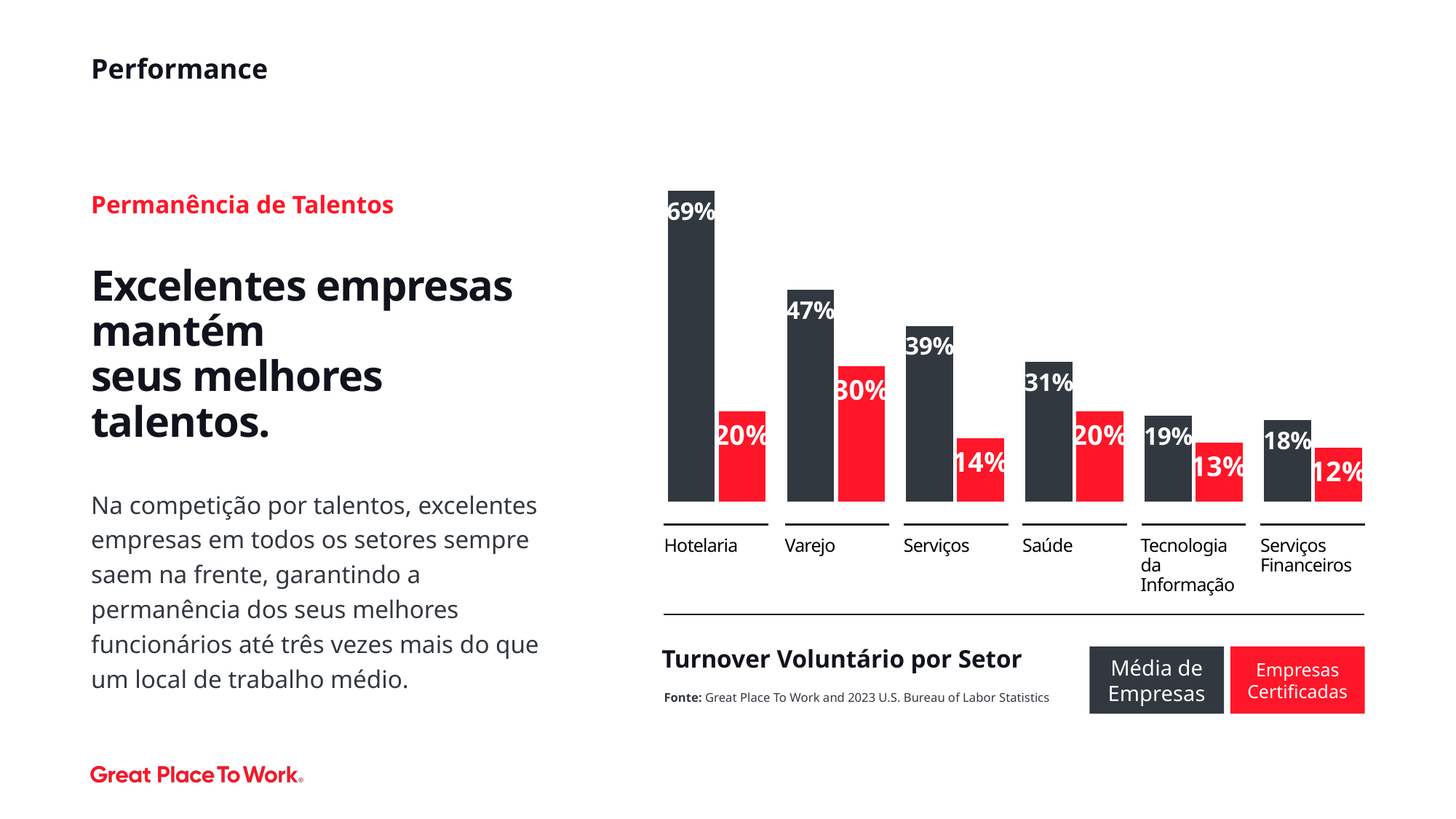
Which is larger: the Empresas Certificadas value for Varejo or for Saúde? Varejo What is the difference between the Média de Empresas and Empresas Certificadas values for Hotelaria? 49 percentage points What is the title of the chart? Turnover Voluntário por Setor What is the Média de Empresas value for Hotelaria? 69% Which sector has the lowest Empresas Certificadas turnover? Serviços Financeiros What is the Empresas Certificadas value for Serviços Financeiros? 12% Which sector has the highest Média de Empresas turnover? Hotelaria Do the Média de Empresas values rise or fall from Hotelaria to Serviços Financeiros? Fall How many series does the legend list? 2 What is the Empresas Certificadas value for Varejo? 30% What kind of chart is shown on the slide? Bar chart How many sectors are shown on the chart? 6